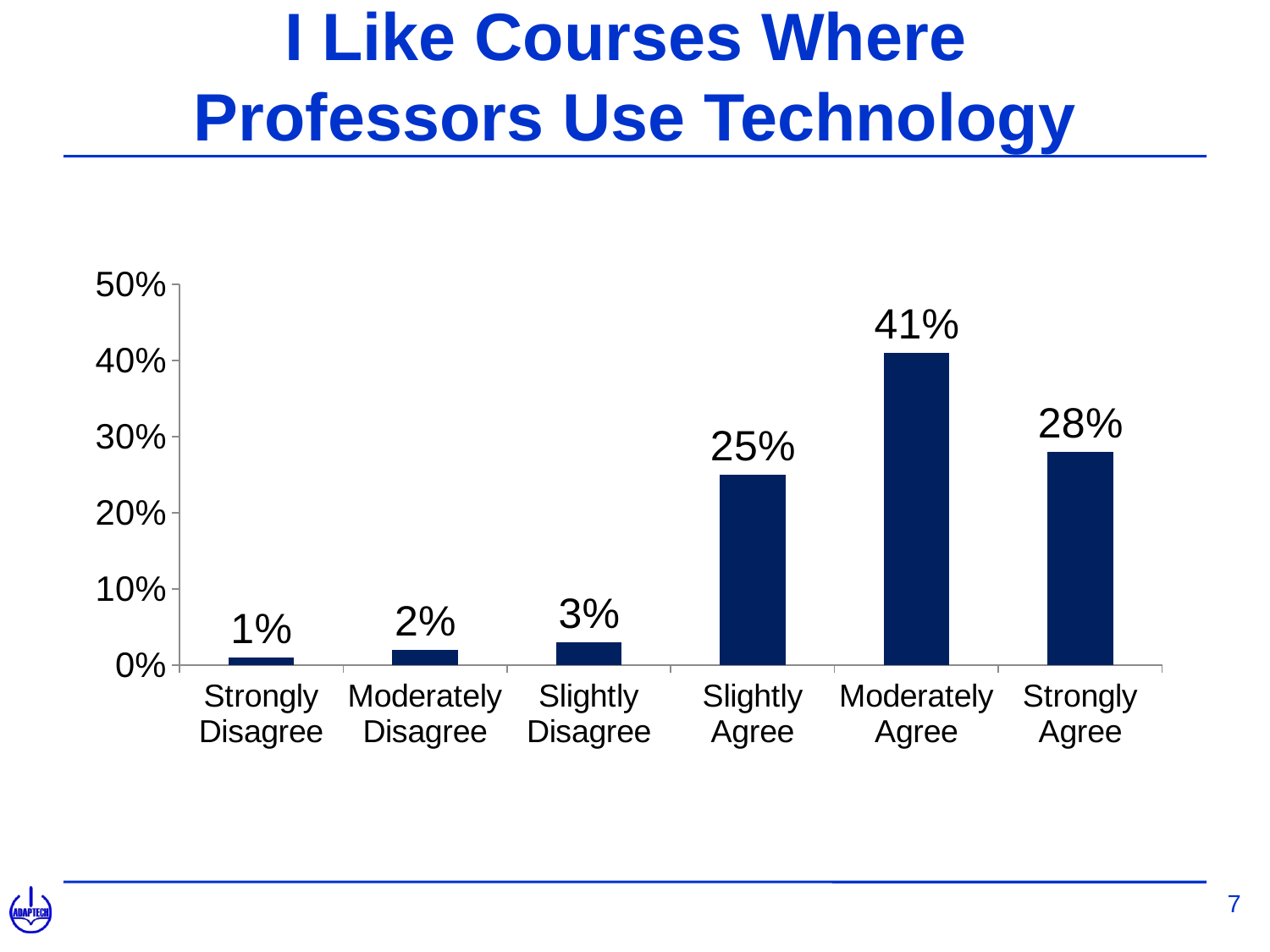
Which category has the highest value? Moderately Agree What percentage of respondents chose Moderately Agree? 41% What is the title of the slide? I Like Courses Where Professors Use Technology How many categories are shown on the x axis? 6 What kind of chart is shown on the slide? Bar chart Is the value for Moderately Agree greater or less than 40%? greater What is the value for Strongly Disagree? 1% What is the difference between Moderately Agree and Strongly Agree? 13% Which is larger, Slightly Agree or Strongly Agree? Strongly Agree What is the combined value of the three Disagree categories? 6% Which category has the lowest value? Strongly Disagree What is the value for Slightly Agree? 25%